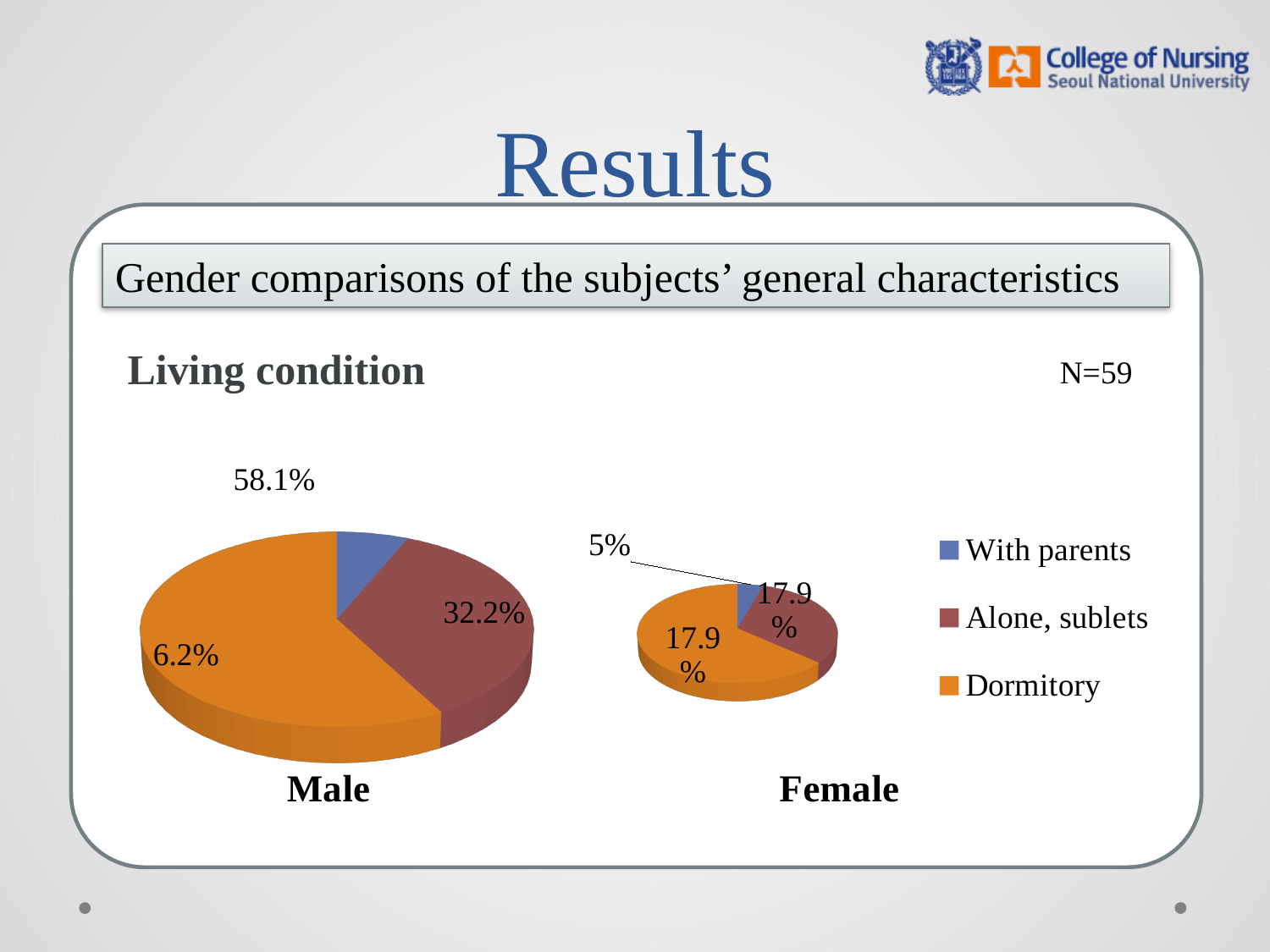
What is the heading above the pie charts? Living condition In the Male pie chart, which living condition has the largest slice? Dormitory What colour represents Dormitory in the legend? Orange What kind of charts are shown on the slide? Pie charts In the Female pie chart, which living condition has the largest slice? Dormitory How many pie charts are on the slide? 2 In the Female pie chart, what value is labelled for With parents? 5% In the Male pie chart, which slice is larger: Dormitory or Alone, sublets? Dormitory In the Male pie chart, which living condition has the smallest slice? With parents In the Female pie chart, which living condition has the smallest slice? With parents How many categories does the legend list? 3 In the Male pie chart, what value is labelled on the Alone, sublets slice? 32.2%